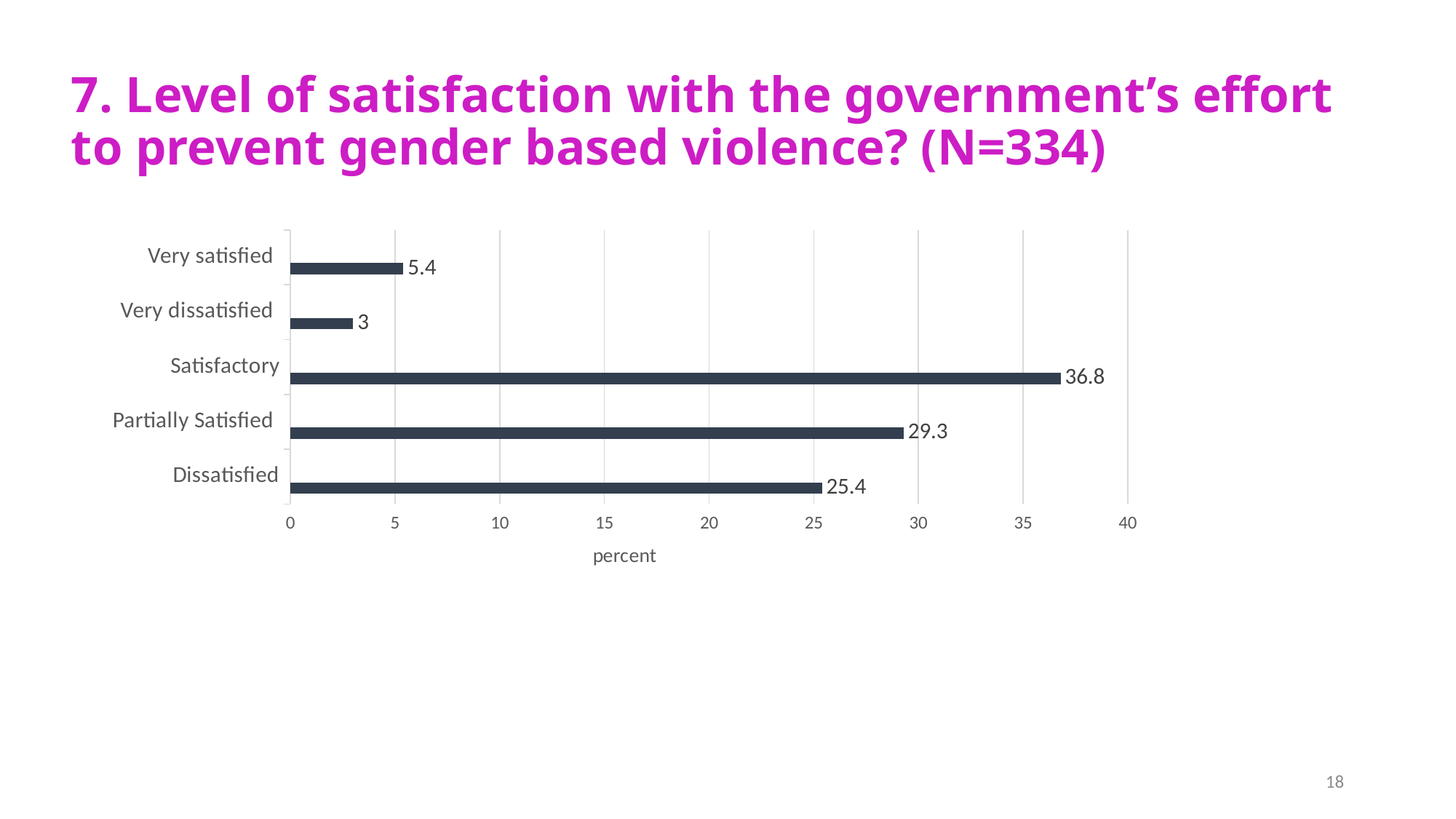
Which is larger, the value for Dissatisfied or the value for Very satisfied? Dissatisfied Is the value for Partially Satisfied greater or less than 25? greater What is the difference between the values for Satisfactory and Partially Satisfied? 7.5 Which category has the highest value? Satisfactory What is the value for Satisfactory? 36.8 What is the value for Dissatisfied? 25.4 How many categories are shown in the chart? 5 What kind of chart is shown on the slide? bar chart Which category has the lowest value? Very dissatisfied What is the label on the horizontal axis of the chart? percent What is the value for Partially Satisfied? 29.3 What is the value for Very dissatisfied? 3